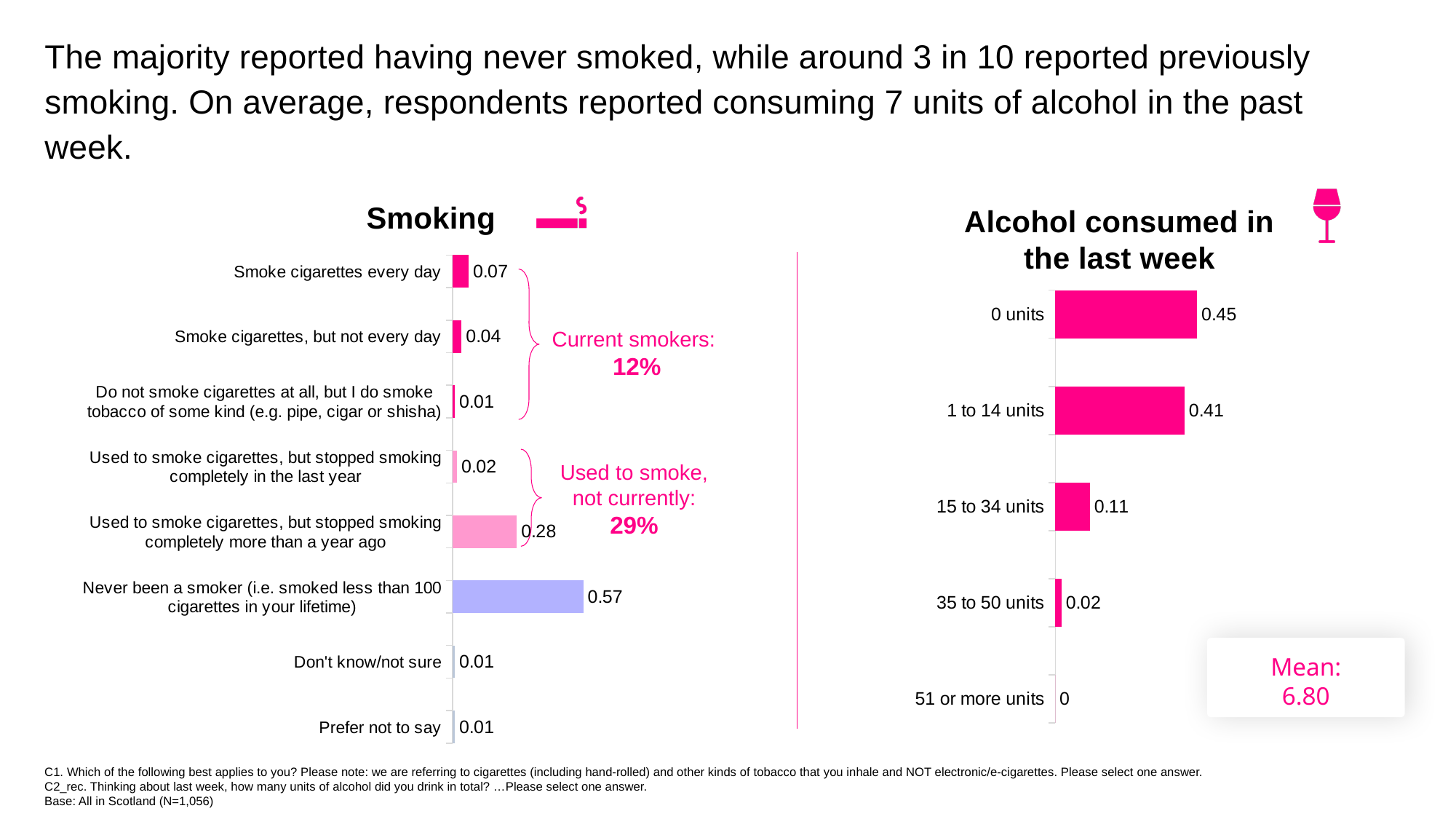
In the Smoking chart, what is the value for 'Never been a smoker (i.e. smoked less than 100 cigarettes in your lifetime)'? 0.57 What type of chart is the 'Alcohol consumed in the last week' chart? Bar chart In the Smoking chart, which category has the highest value? Never been a smoker (i.e. smoked less than 100 cigarettes in your lifetime) How many categories are shown in the 'Alcohol consumed in the last week' chart? 5 In the Smoking chart, what is the value for 'Smoke cigarettes every day'? 0.07 In the Smoking chart, which is larger: 'Smoke cigarettes every day' or 'Smoke cigarettes, but not every day'? Smoke cigarettes every day In the 'Alcohol consumed in the last week' chart, which category has the lowest value? 51 or more units What mean value is shown next to the 'Alcohol consumed in the last week' chart? 6.80 In the 'Alcohol consumed in the last week' chart, what is the difference between '0 units' and '15 to 34 units'? 0.34 In the Smoking chart, what is the difference between 'Never been a smoker' and 'Used to smoke cigarettes, but stopped smoking completely more than a year ago'? 0.29 How many categories are shown in the Smoking chart? 8 In the 'Alcohol consumed in the last week' chart, what is the value for '1 to 14 units'? 0.41